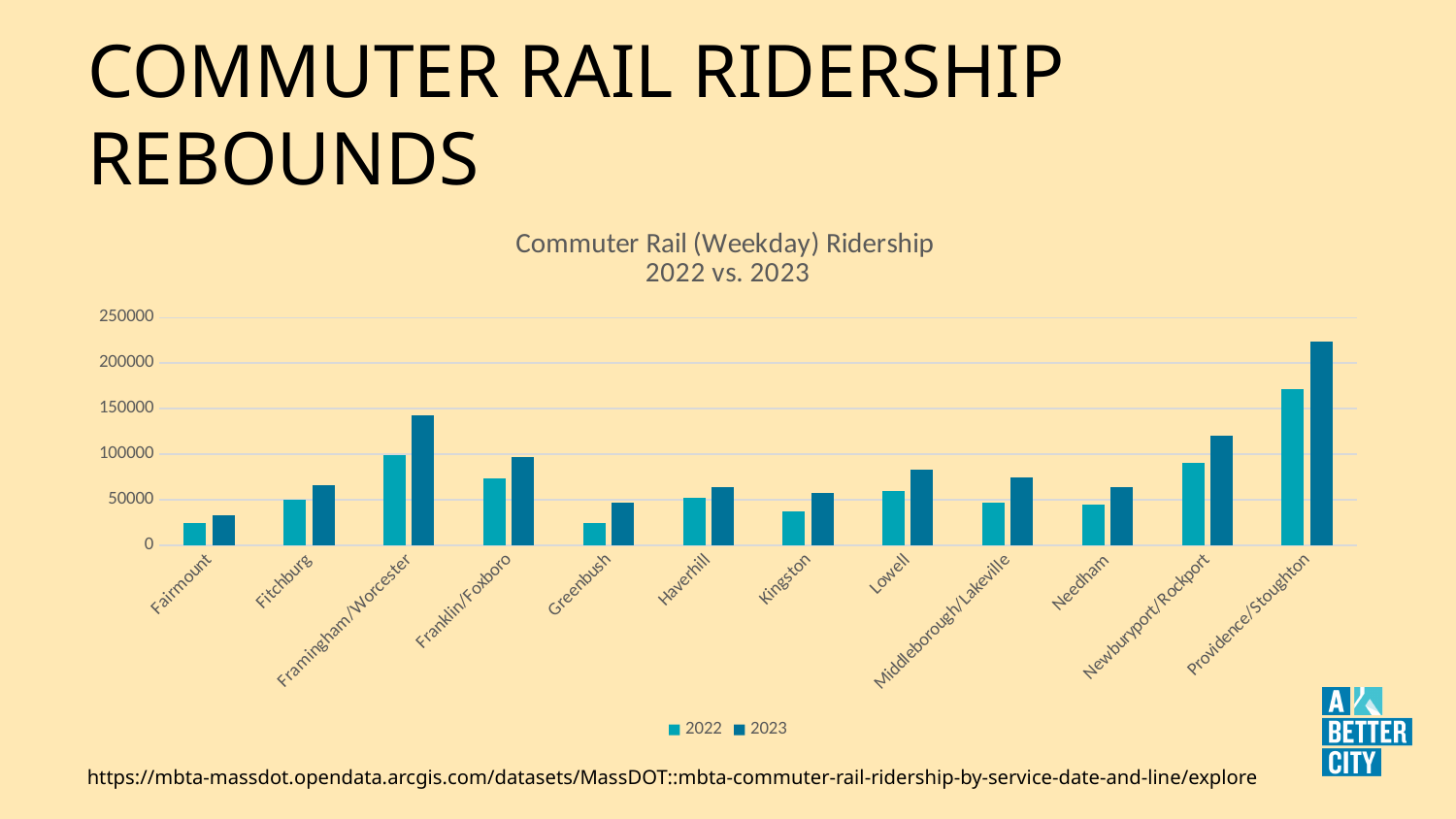
Is the 2022 value for Fairmount greater or less than 50000? less Which is larger, the 2023 value for Framingham/Worcester or the 2023 value for Newburyport/Rockport? Framingham/Worcester Is the 2022 value for Newburyport/Rockport greater or less than 100000? less How many series does the legend list? 2 What is the title of the chart? Commuter Rail (Weekday) Ridership 2022 vs. 2023 Is the 2023 value for Providence/Stoughton greater or less than 200000? greater How many commuter rail lines are shown on the x axis? 12 Which line has the highest 2023 weekday ridership? Providence/Stoughton Which line has the highest 2022 weekday ridership? Providence/Stoughton Which line has the lowest 2023 weekday ridership? Fairmount What kind of chart is shown on the slide? Bar chart